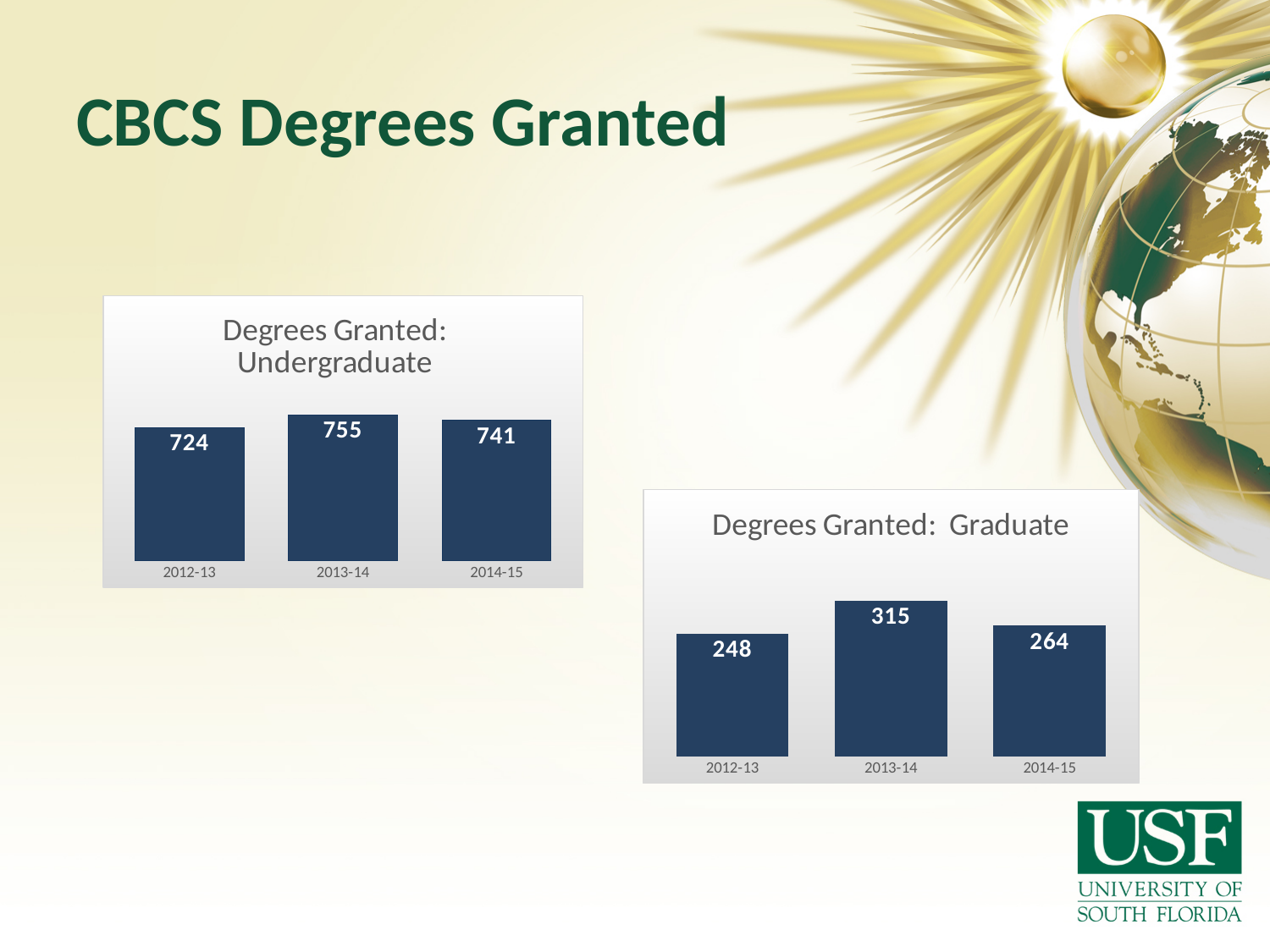
How many bars are in the 'Degrees Granted: Undergraduate' chart? 3 In the 'Degrees Granted: Undergraduate' chart, does the value rise or fall from 2013-14 to 2014-15? Fall What kind of chart is the 'Degrees Granted: Graduate' chart? Bar chart In the 'Degrees Granted: Graduate' chart, which year has the lowest value? 2012-13 In the 'Degrees Granted: Graduate' chart, which is larger, the value for 2012-13 or the value for 2014-15? 2014-15 In the 'Degrees Granted: Undergraduate' chart, what is the difference between the 2013-14 and 2014-15 values? 14 In the 'Degrees Granted: Undergraduate' chart, what is the value for 2012-13? 724 In the 'Degrees Granted: Undergraduate' chart, what is the value for 2013-14? 755 In the 'Degrees Granted: Graduate' chart, what is the value for 2014-15? 264 In the 'Degrees Granted: Undergraduate' chart, which year has the lowest value? 2012-13 In the 'Degrees Granted: Graduate' chart, which year has the highest value? 2013-14 In the 'Degrees Granted: Graduate' chart, what is the difference between the 2013-14 and 2012-13 values? 67